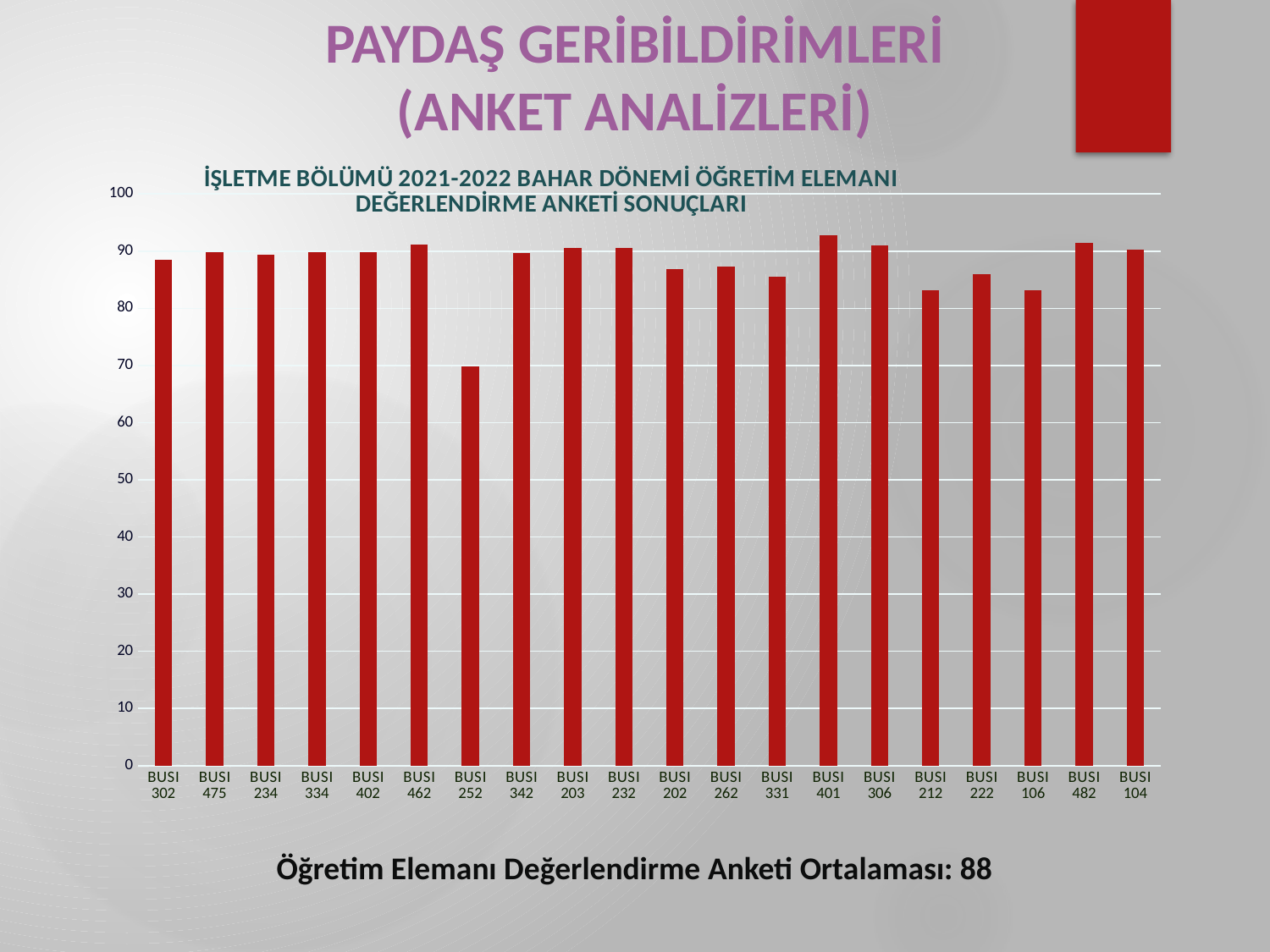
What colour are the bars in the chart? red Is the value for BUSI 252 greater or less than 80? less Is the value for BUSI 302 greater or less than 80? greater What is the title of the chart? İŞLETME BÖLÜMÜ 2021-2022 BAHAR DÖNEMİ ÖĞRETİM ELEMANI DEĞERLENDİRME ANKETİ SONUÇLARI How many courses (bars) are shown in the chart? 20 Is the value for BUSI 212 greater or less than 90? less Which has the larger value, BUSI 401 or BUSI 212? BUSI 401 Which has the larger value, BUSI 302 or BUSI 252? BUSI 302 What kind of chart is shown on the slide? bar chart Which course has the lowest value in the chart? BUSI 252